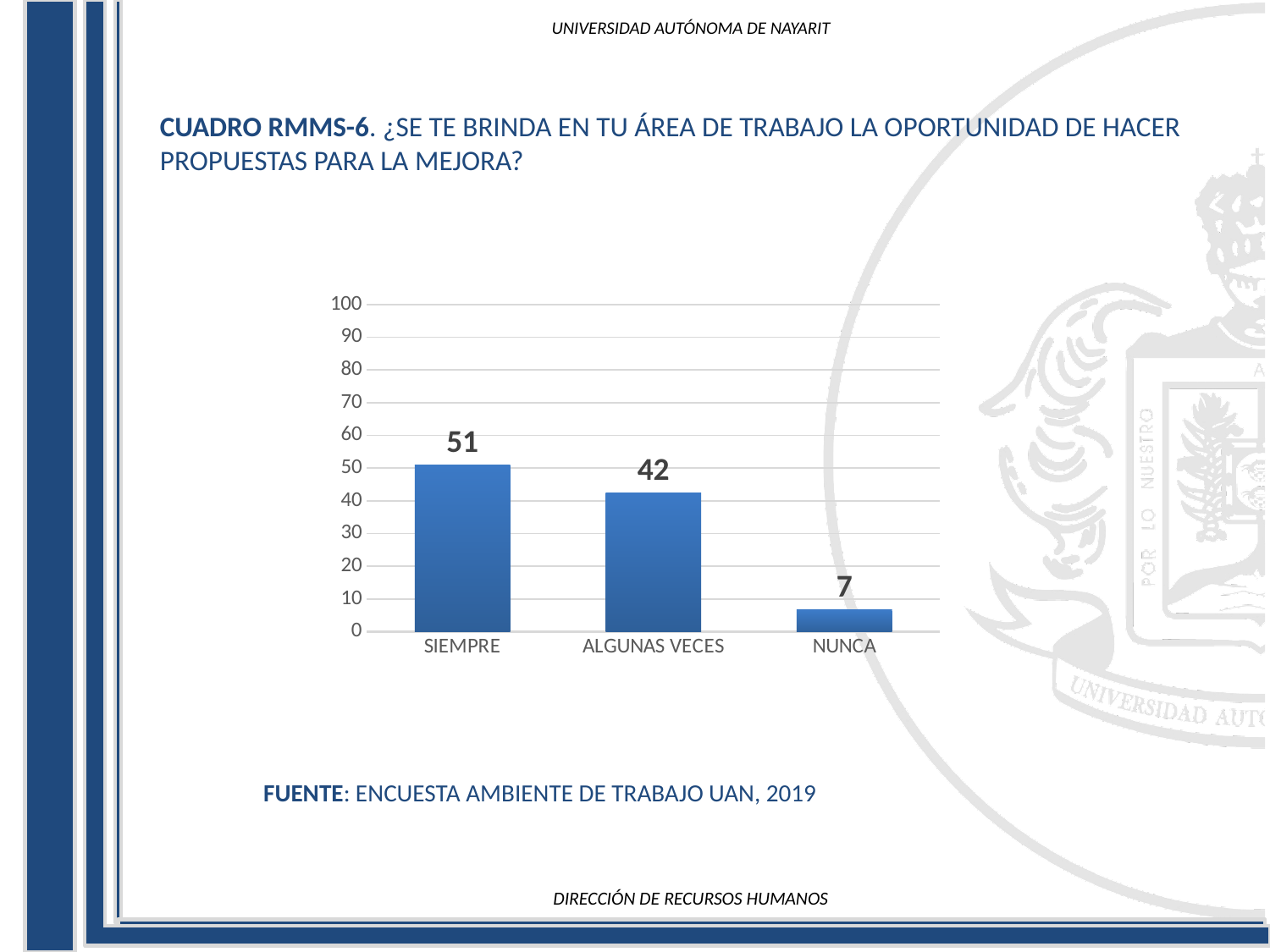
What is the difference between the values for SIEMPRE and ALGUNAS VECES? 9 How many categories are shown on the x axis? 3 Which is larger, the value for ALGUNAS VECES or the value for NUNCA? ALGUNAS VECES What is the value for ALGUNAS VECES? 42 Do the values rise or fall from left to right along the x axis? fall Which category has the lowest value? NUNCA What kind of chart is shown on the slide? bar chart What is the difference between the values for ALGUNAS VECES and NUNCA? 35 What is the value for NUNCA? 7 Which category has the highest value? SIEMPRE What is the value for SIEMPRE? 51 Is the value for SIEMPRE greater or less than 60? less